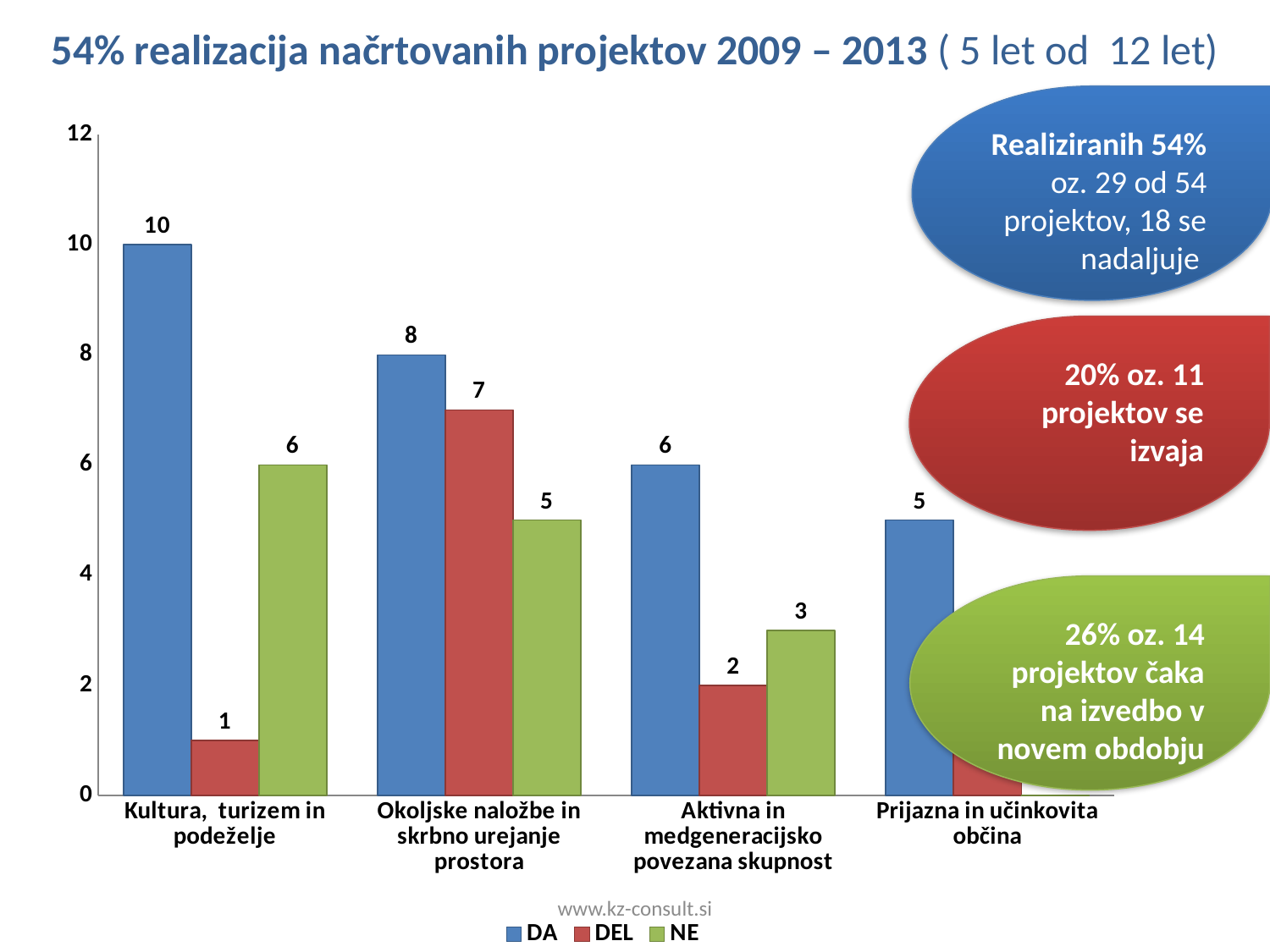
What is the DEL value for Okoljske naložbe in skrbno urejanje prostora? 7 Which category has the lowest DEL value among those with a printed DEL label? Kultura, turizem in podeželje What is the DA value for Kultura, turizem in podeželje? 10 How many categories are shown on the x axis? 4 Which category has the highest DA value? Kultura, turizem in podeželje What is the DA value for Prijazna in učinkovita občina? 5 Which is larger for Okoljske naložbe in skrbno urejanje prostora: the DA value or the NE value? DA What is the NE value for Aktivna in medgeneracijsko povezana skupnost? 3 How many series does the legend list? 3 What kind of chart is shown on the slide? bar chart Is the DA value for Aktivna in medgeneracijsko povezana skupnost greater or less than 4? greater What is the difference between the DA and NE values for Kultura, turizem in podeželje? 4